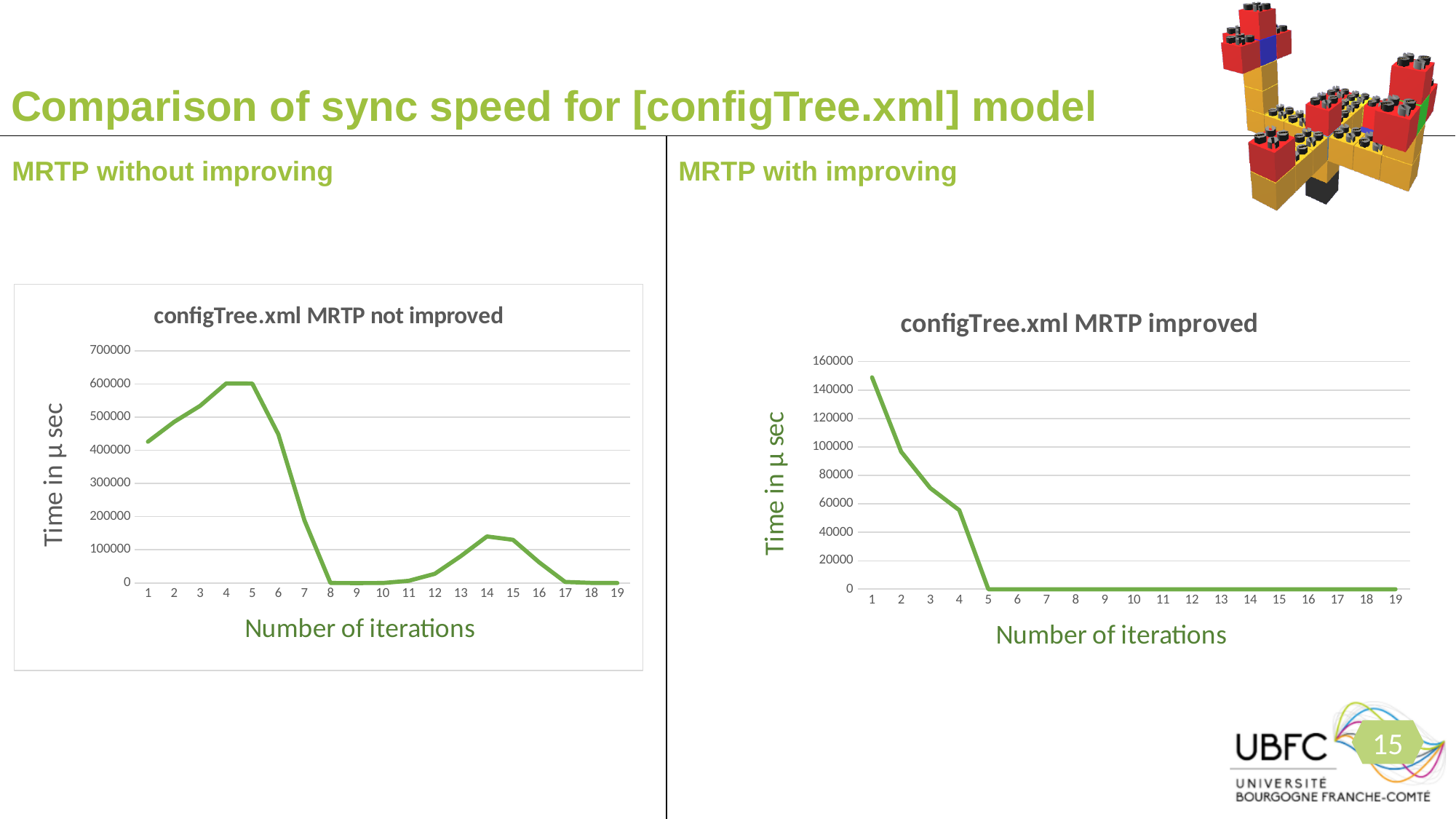
In the 'configTree.xml MRTP not improved' chart, is the value for iteration 8 greater or less than 100000? less In the 'configTree.xml MRTP improved' chart, do the values rise or fall from iteration 1 to iteration 5? fall What is the x-axis label of the 'configTree.xml MRTP not improved' chart? Number of iterations In the 'configTree.xml MRTP improved' chart, which iteration has the highest time? 1 In the 'configTree.xml MRTP not improved' chart, is the value for iteration 1 greater or less than 400000? greater In the 'configTree.xml MRTP not improved' chart, which has the larger value, iteration 1 or iteration 8? iteration 1 What kind of chart is the 'configTree.xml MRTP not improved' chart? line chart How many iterations are plotted on the x axis of the 'configTree.xml MRTP improved' chart? 19 In the 'configTree.xml MRTP not improved' chart, is the value for iteration 14 greater or less than 100000? greater What is the y-axis label of the 'configTree.xml MRTP improved' chart? Time in µ sec